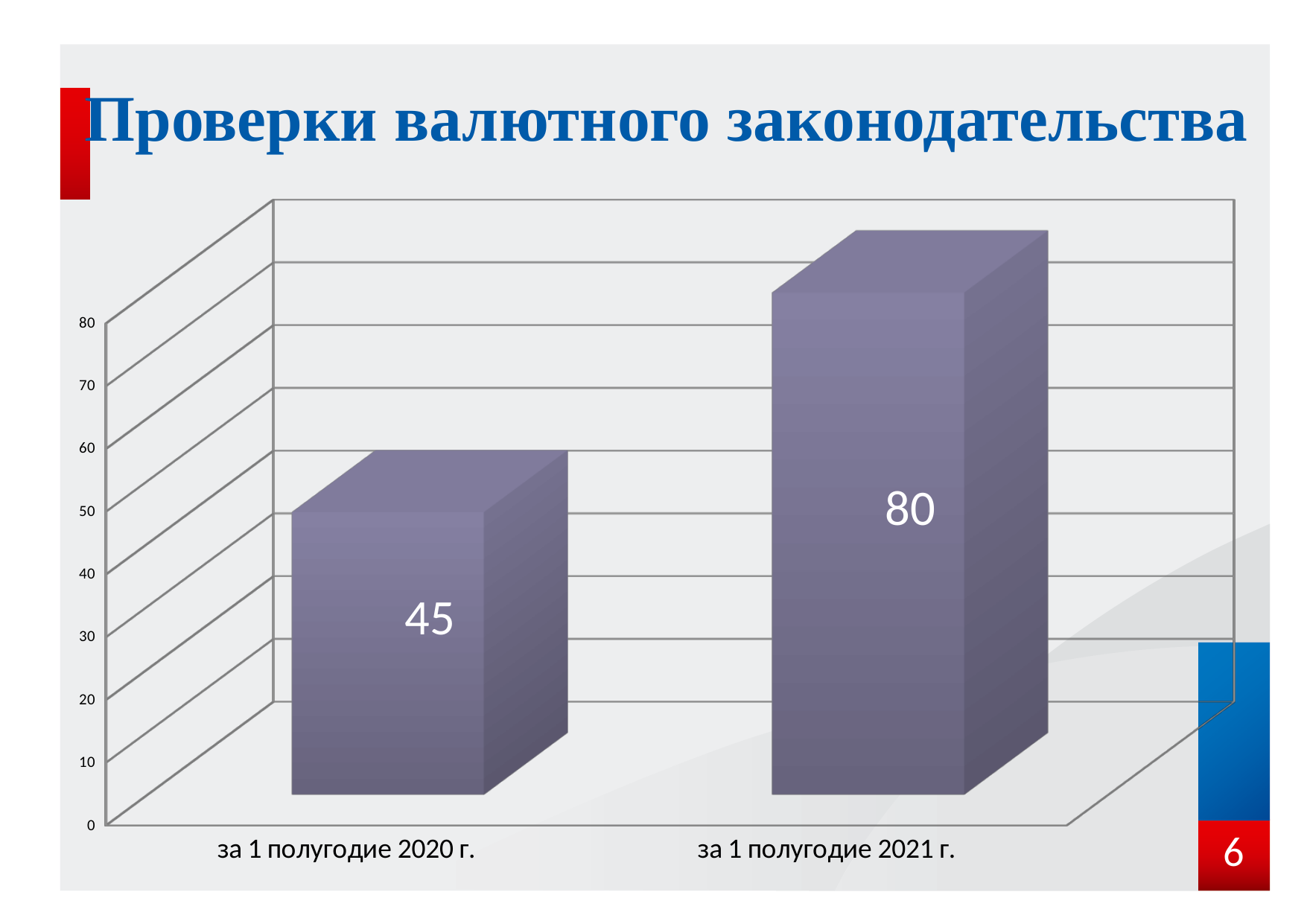
Which category has the lowest value? за 1 полугодие 2020 г. What is the value for за 1 полугодие 2021 г.? 80 What is the value for за 1 полугодие 2020 г.? 45 Do the values rise or fall from за 1 полугодие 2020 г. to за 1 полугодие 2021 г.? rise Which is larger: the value for за 1 полугодие 2020 г. or за 1 полугодие 2021 г.? за 1 полугодие 2021 г. What kind of chart is shown on the slide? bar chart What is the difference between the values for за 1 полугодие 2021 г. and за 1 полугодие 2020 г.? 35 Which category has the highest value? за 1 полугодие 2021 г. What is the title of the slide? Проверки валютного законодательства Is the value for за 1 полугодие 2021 г. greater or less than 70? greater How many categories are shown on the chart? 2 Is the value for за 1 полугодие 2020 г. greater or less than 50? less